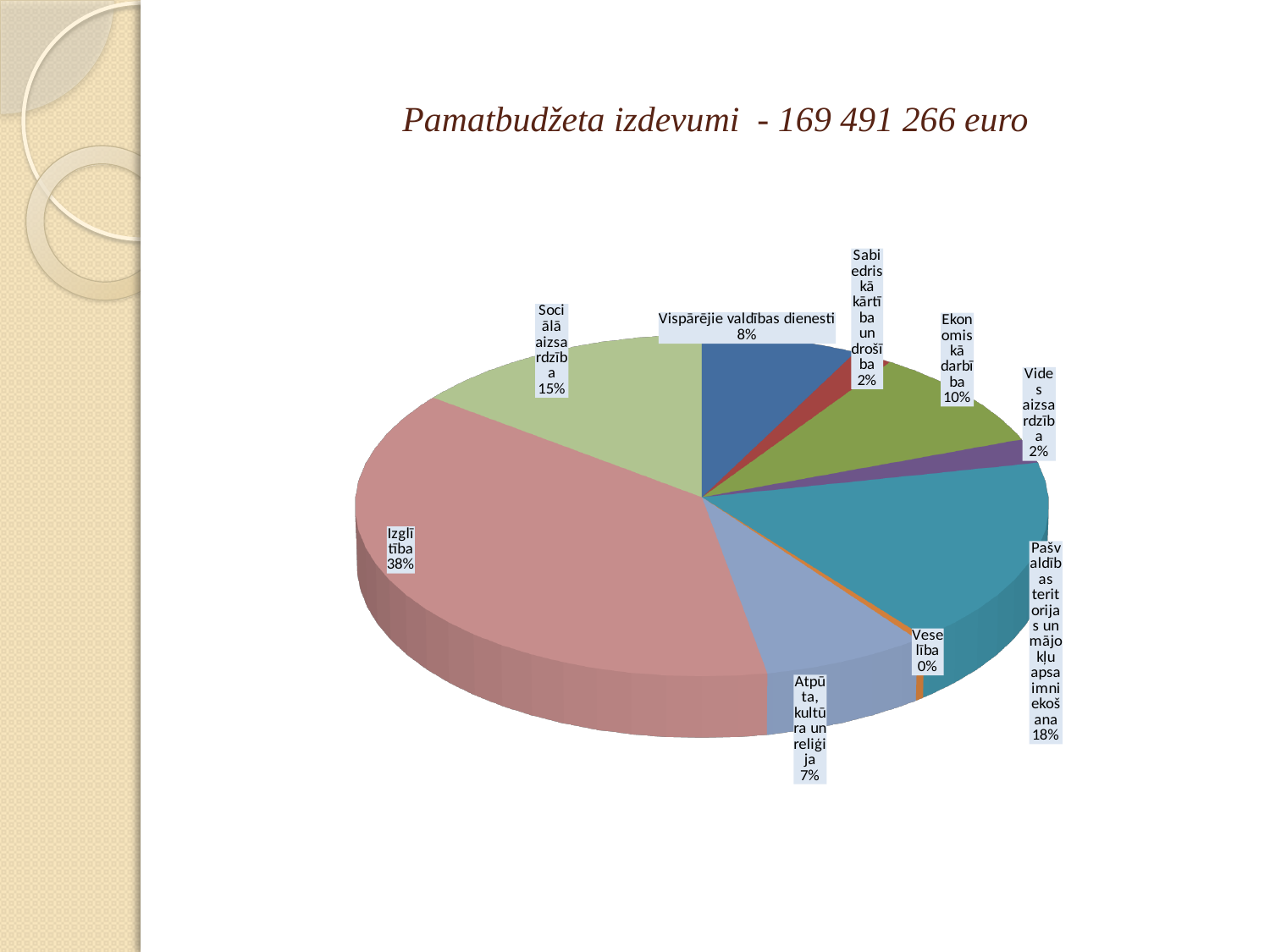
What share of the pie does Izglītība have? 38% What percentage is shown for Sociālā aizsardzība? 15% What percentage is shown for Veselība? 0% Which category has the largest slice of the pie? Izglītība What percentage is shown for Ekonomiskā darbība? 10% What is the difference in percentage points between Izglītība and Pašvaldības teritorijas un mājokļu apsaimniekošana? 20 percentage points What type of chart is shown on the slide? Pie chart What is the title of the chart? Pamatbudžeta izdevumi - 169 491 266 euro What percentage is shown for Pašvaldības teritorijas un mājokļu apsaimniekošana? 18% Which category has the smallest slice of the pie? Veselība Which is larger, Vispārējie valdības dienesti or Atpūta, kultūra un reliģija? Vispārējie valdības dienesti How many categories are shown in the pie chart? 9